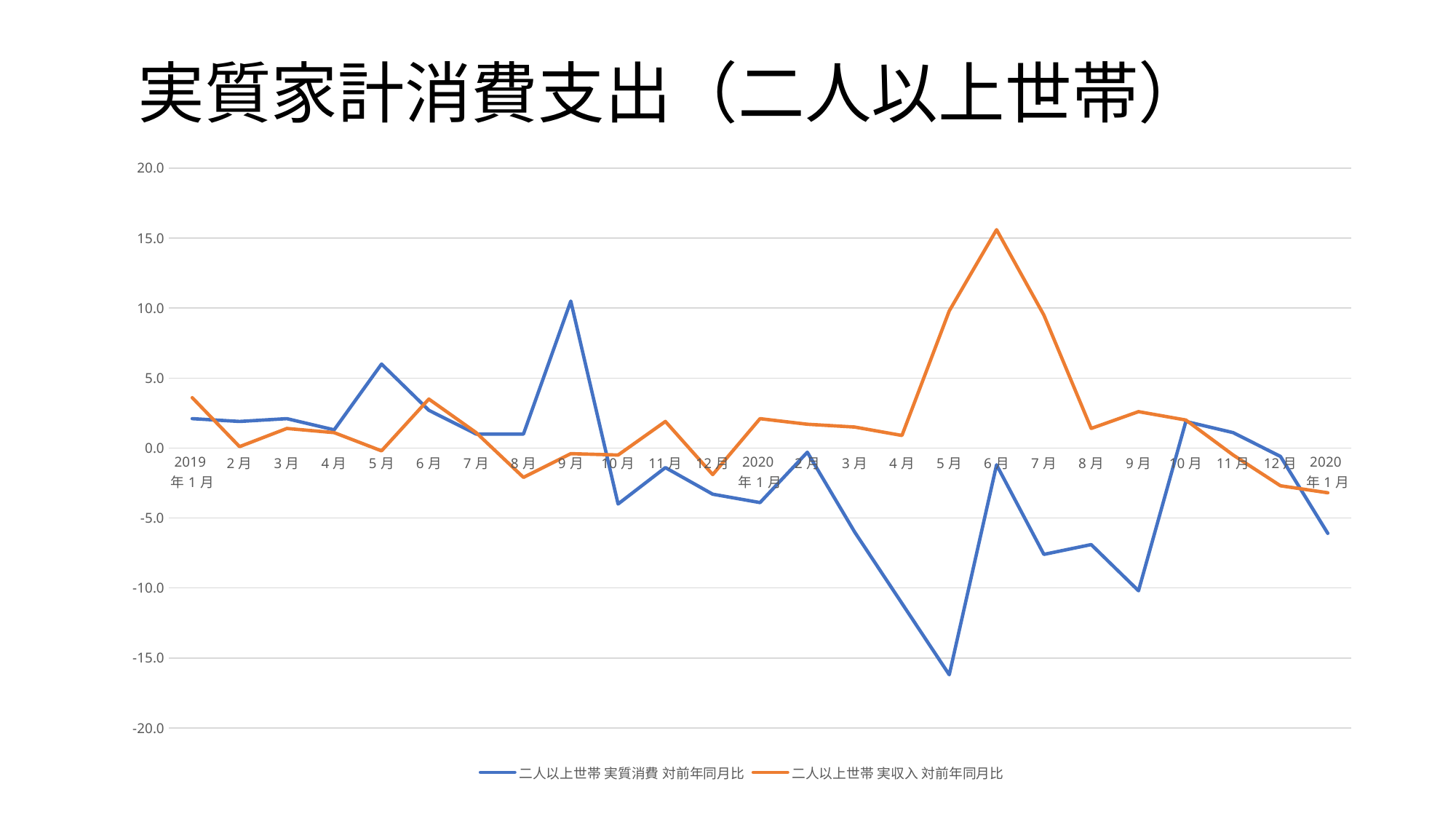
In which month does the 二人以上世帯 実収入 対前年同月比 series reach its highest value? 2020年6月 Is the value for 二人以上世帯 実収入 対前年同月比 in 2020年6月 greater or less than 10.0? greater How many series does the legend list? 2 In which month does the 二人以上世帯 実質消費 対前年同月比 series reach its highest value? 2019年9月 What is the title of the chart? 実質家計消費支出（二人以上世帯） In which month does the 二人以上世帯 実質消費 対前年同月比 series reach its lowest value? 2020年5月 Is the value for 二人以上世帯 実質消費 対前年同月比 in 2020年5月 greater or less than -10.0? less Which series is drawn in orange? 二人以上世帯 実収入 対前年同月比 Does the 二人以上世帯 実質消費 対前年同月比 series rise or fall from 2020年1月 to 2020年5月? fall What kind of chart is shown on the slide? Line chart How many points are plotted along the x axis for each series? 25 In 2020年5月, which series has the higher value, 実質消費 or 実収入? 実収入